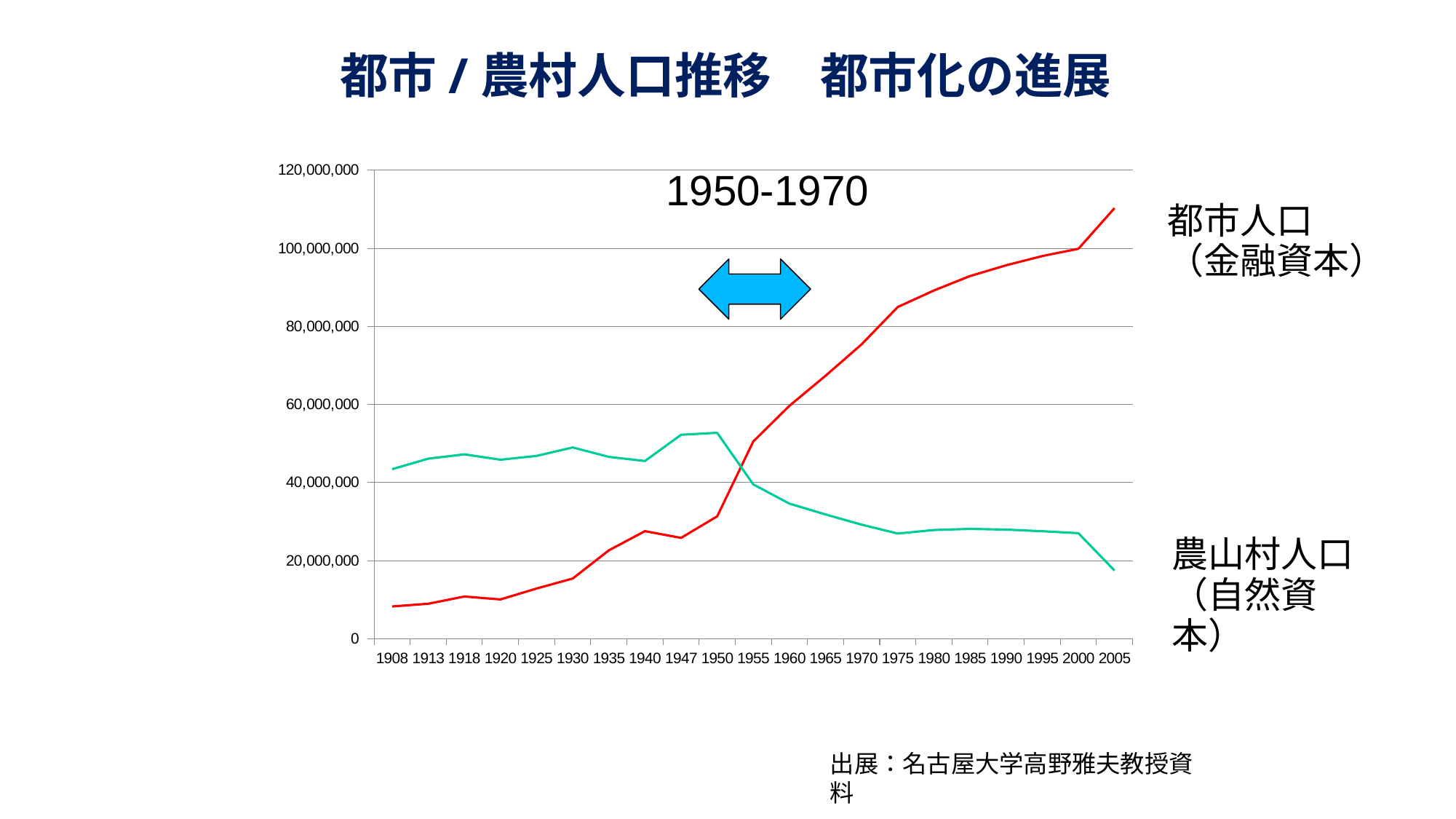
Is the 都市人口 value for 2005 greater or less than 100,000,000? greater What is the title of the slide? 都市 / 農村人口推移 都市化の進展 Is the 都市人口 value for 1908 greater or less than 20,000,000? less Is the 農山村人口 value for 2005 greater or less than 20,000,000? less In which year is the 農山村人口 (rural population) line at its lowest? 2005 What kind of chart is shown on the slide? line chart How many series are plotted in the chart? 2 How many years are shown along the x axis of the chart? 21 Does the 農山村人口 line rise or fall between 1950 and 2005? fall In which year is the 都市人口 (urban population) line at its highest? 2005 In which year is the 都市人口 (urban population) line at its lowest? 1908 Which series has the larger value in 1908, 都市人口 or 農山村人口? 農山村人口